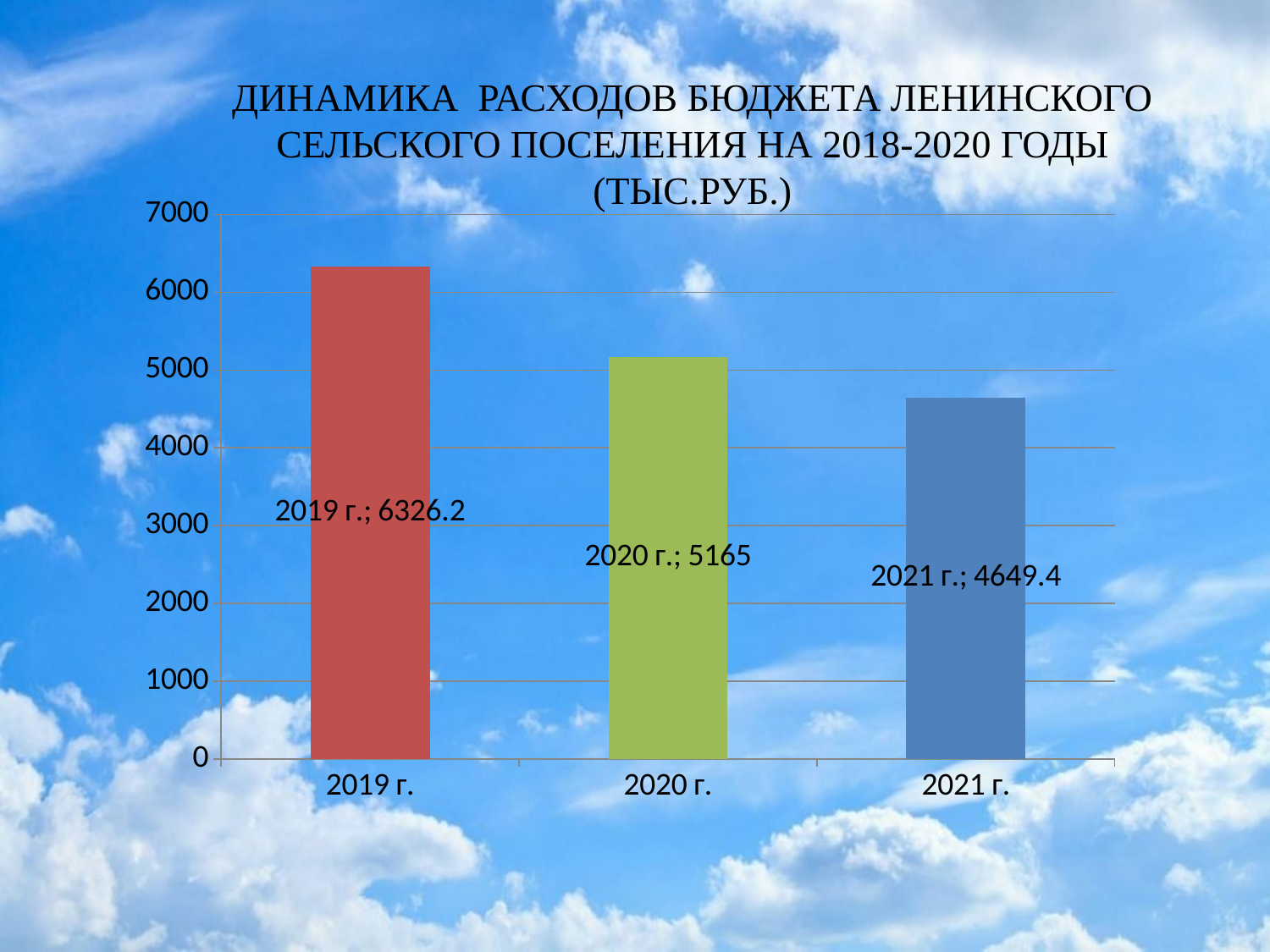
What is the value for 2021 г.? 4649.4 What is the value for 2019 г.? 6326.2 What is the difference between the values for 2019 г. and 2020 г.? 1161.2 Which year has the highest value? 2019 г. Is the value for 2019 г. greater or less than 6000? greater What is the value for 2020 г.? 5165 What is the difference between the values for 2020 г. and 2021 г.? 515.6 What kind of chart is shown on the slide? bar chart Do the values rise or fall from 2019 г. to 2021 г.? fall How many years are shown on the x axis? 3 Which year has the lowest value? 2021 г. Which is larger, the value for 2020 г. or the value for 2021 г.? 2020 г.